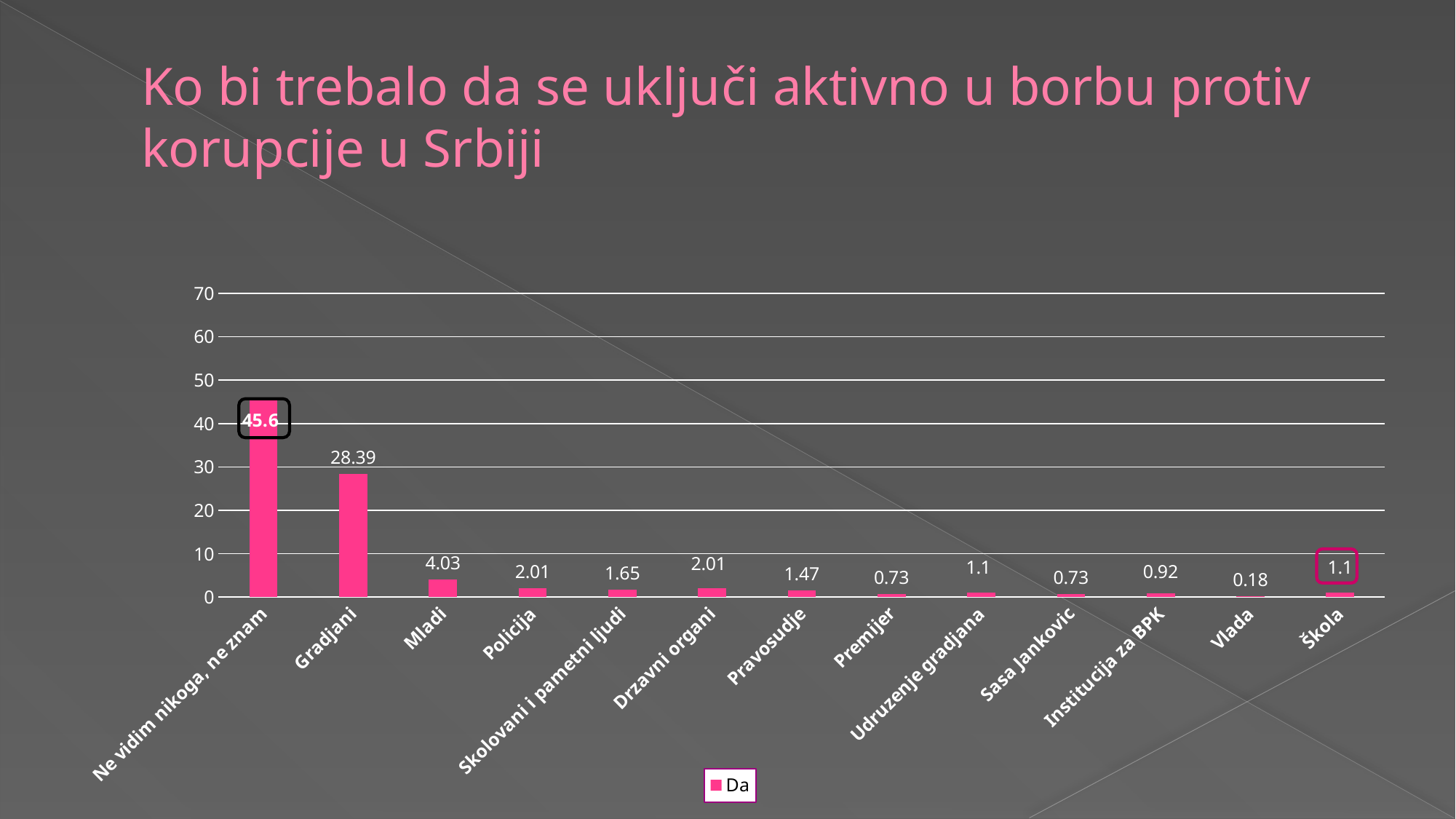
What kind of chart is shown on the slide? Bar chart What is the value for Gradjani? 28.39 How many categories are shown on the x axis? 13 What is the value for Vlada? 0.18 Which category has the lowest value? Vlada What is the value for Mladi? 4.03 What is the difference between the values for Ne vidim nikoga, ne znam and Gradjani? 17.21 Which is larger, the value for Mladi or the value for Policija? Mladi What is the value for Institucija za BPK? 0.92 How many series does the legend list? 1 What is the name of the series shown in the legend? Da Which category has the highest value? Ne vidim nikoga, ne znam